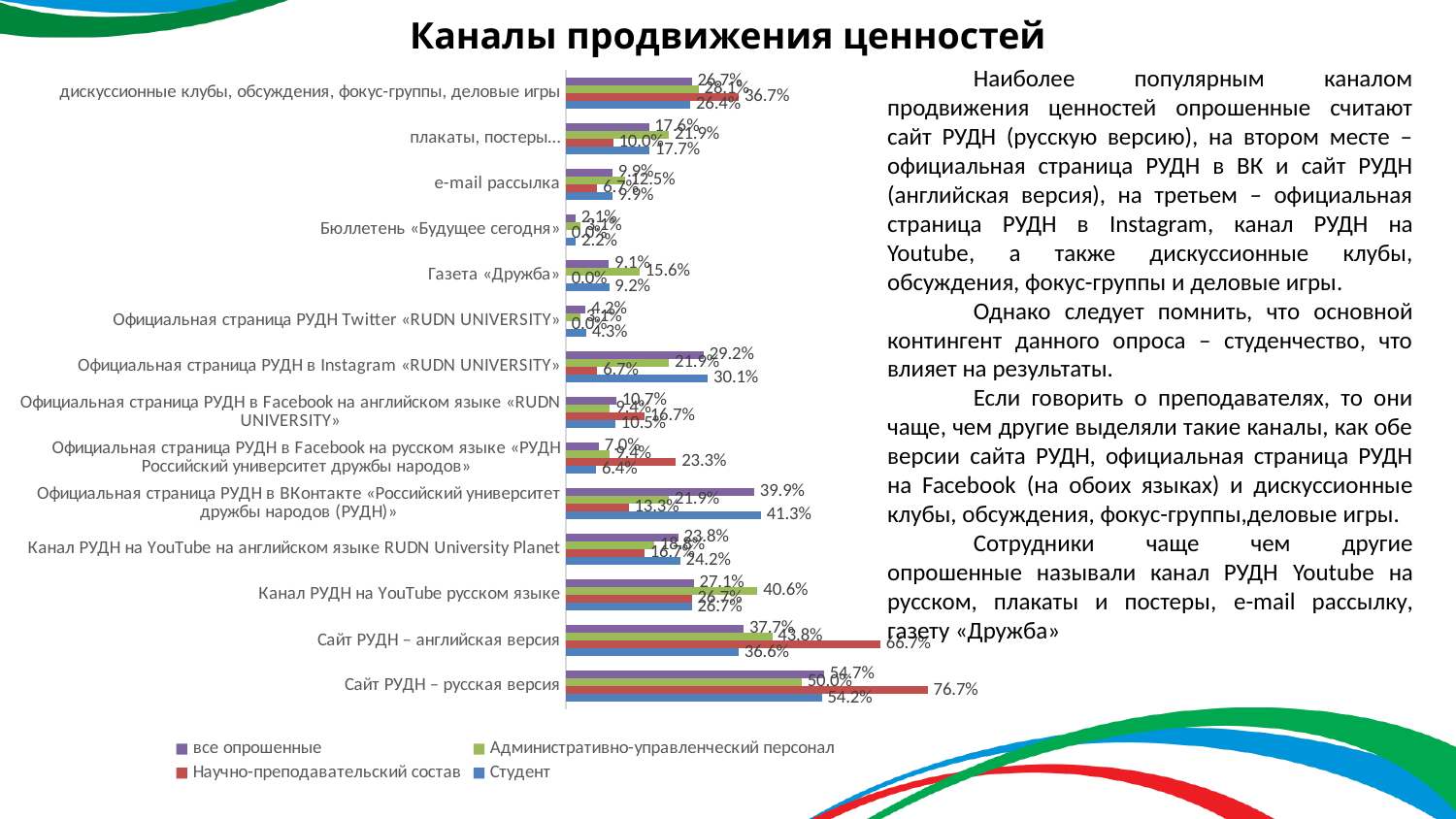
What is the value for Научно-преподавательский состав for «Газета «Дружба»»? 0.0% What colour represents the Студент series in the chart? Blue How many channel categories are plotted on the chart? 14 What is the value for Научно-преподавательский состав for «Сайт РУДН – русская версия»? 76.7% How many series does the legend of the chart list? 4 Which category has the highest value for Научно-преподавательский состав? Сайт РУДН – русская версия What is the value for Студент for «Официальная страница РУДН в ВКонтакте»? 41.3% What kind of chart is shown on the slide? Bar chart For the Студент series, which is larger: «Официальная страница РУДН в Instagram» or «Официальная страница РУДН в ВКонтакте»? Официальная страница РУДН в ВКонтакте What is the difference between the Научно-преподавательский состав values for «Сайт РУДН – русская версия» and «Сайт РУДН – английская версия»? 10.0 percentage points What is the difference between the Студент values for «Сайт РУДН – русская версия» and «Сайт РУДН – английская версия»? 17.6 percentage points What is the value for Административно-управленческий персонал for «Канал РУДН на YouTube русском языке»? 40.6%